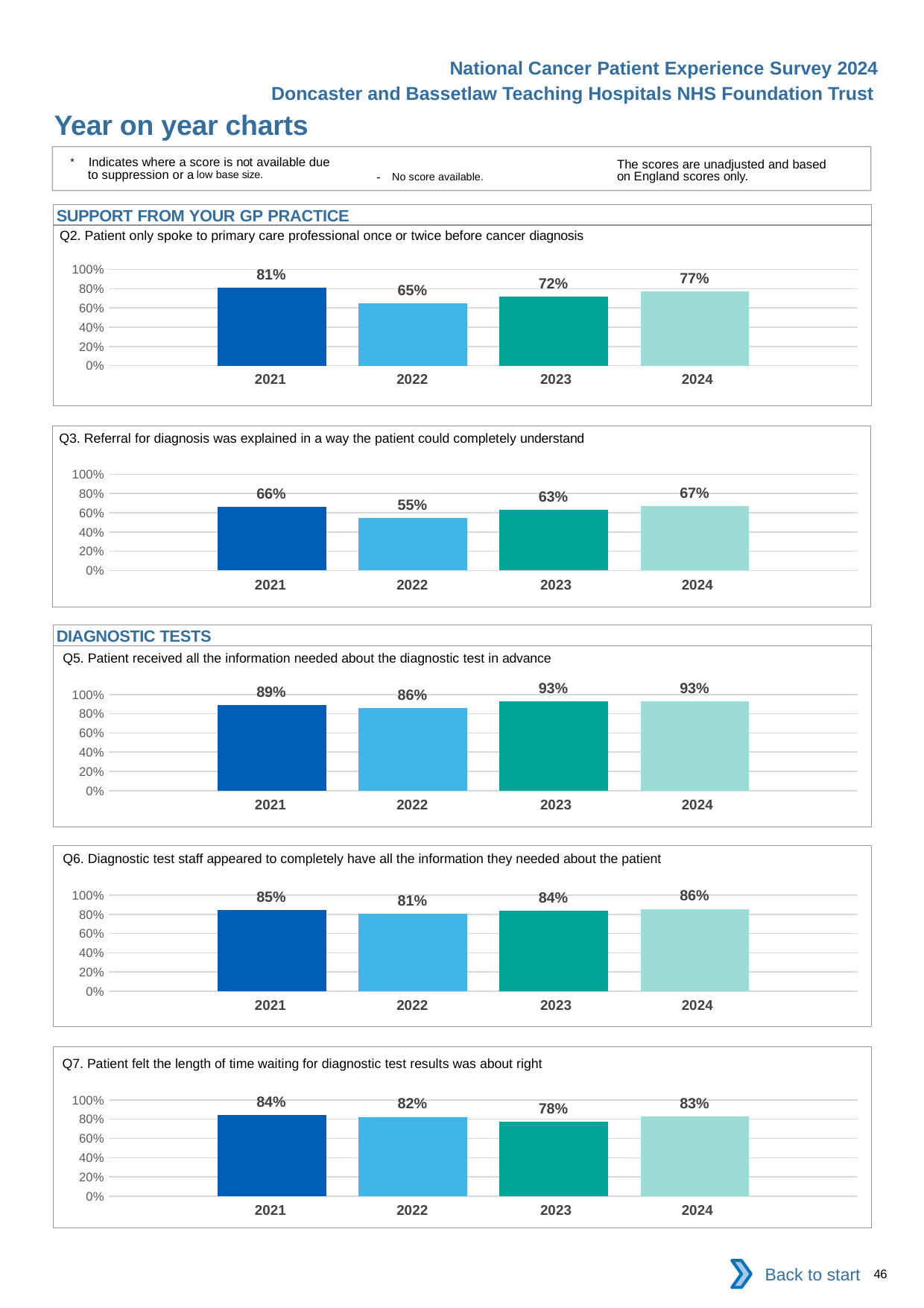
What type of chart is used for Q5? Bar chart In the Q5 chart (patient received all the information needed about the diagnostic test in advance), what is the value for 2024? 93% In the Q5 chart, is the value for 2021 greater or less than 80%? greater In the Q6 chart, what is the difference between the 2024 and 2022 values? 5% In the Q7 chart, which year has the highest value? 2021 How many years (categories) are shown in the Q2 chart? 4 In the Q2 chart (patient only spoke to primary care professional once or twice before cancer diagnosis), what is the value for 2022? 65% In the Q6 chart (diagnostic test staff appeared to completely have all the information they needed), which is larger: the 2021 value or the 2022 value? 2021 In the Q3 chart, what is the difference between the 2024 and 2023 values? 4% In the Q2 chart, which year has the highest value? 2021 In the Q3 chart (referral for diagnosis was explained in a way the patient could completely understand), which year has the lowest value? 2022 In the Q7 chart (patient felt the length of time waiting for diagnostic test results was about right), what is the value for 2023? 78%